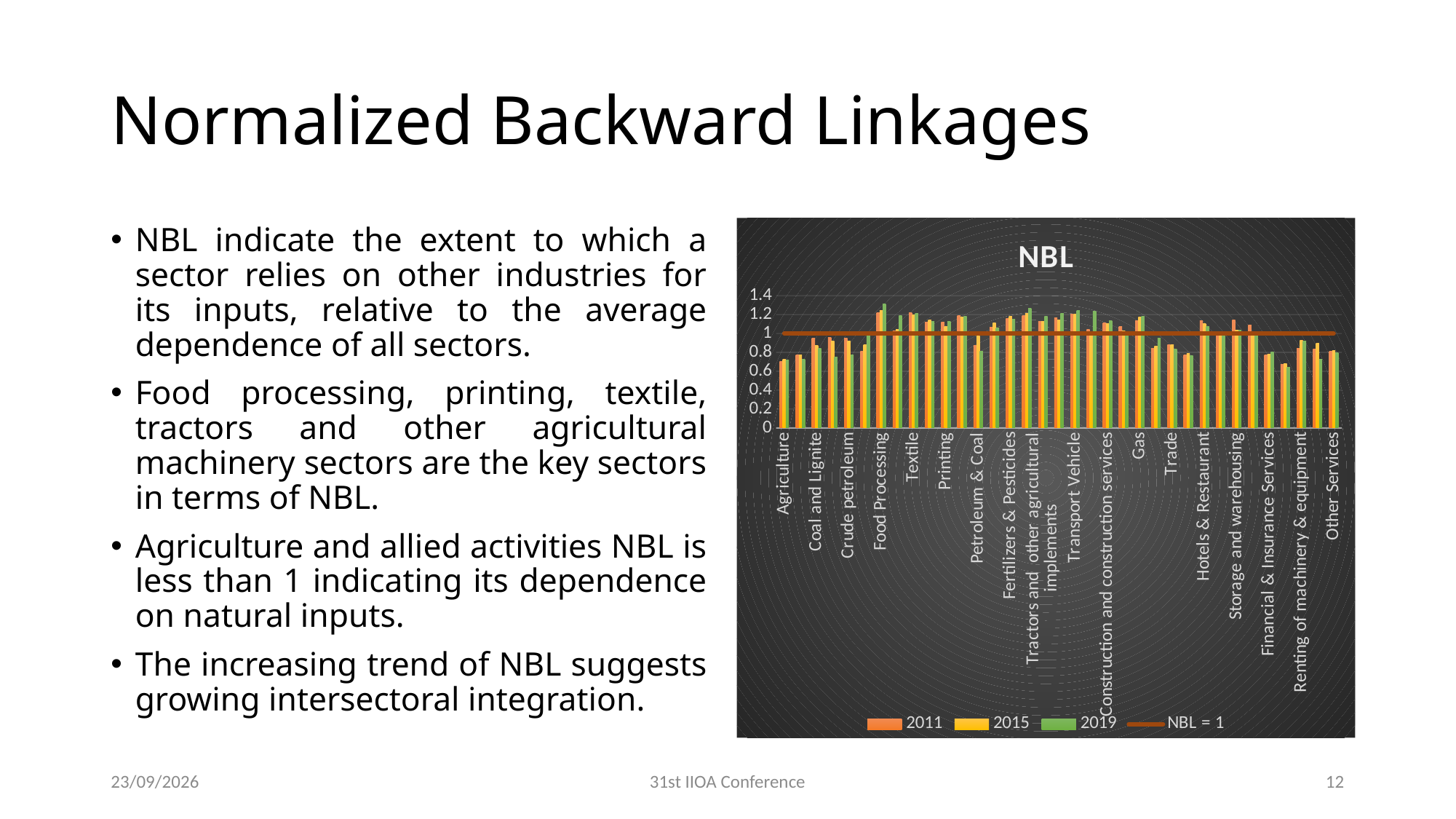
What is the title of the chart? NBL Is the 2019 value for Textile greater or less than 1? greater Is the 2011 value for Financial & Insurance Services greater or less than 1? less Which has the larger 2019 value, Food Processing or Agriculture? Food Processing How many entries does the chart legend list? 4 Is the 2015 value for Renting of machinery & equipment greater or less than 1? less What does the horizontal line drawn across the chart represent, according to the legend? NBL = 1 Which has the larger 2015 value, Textile or Renting of machinery & equipment? Textile What type of chart is shown on the slide? bar chart